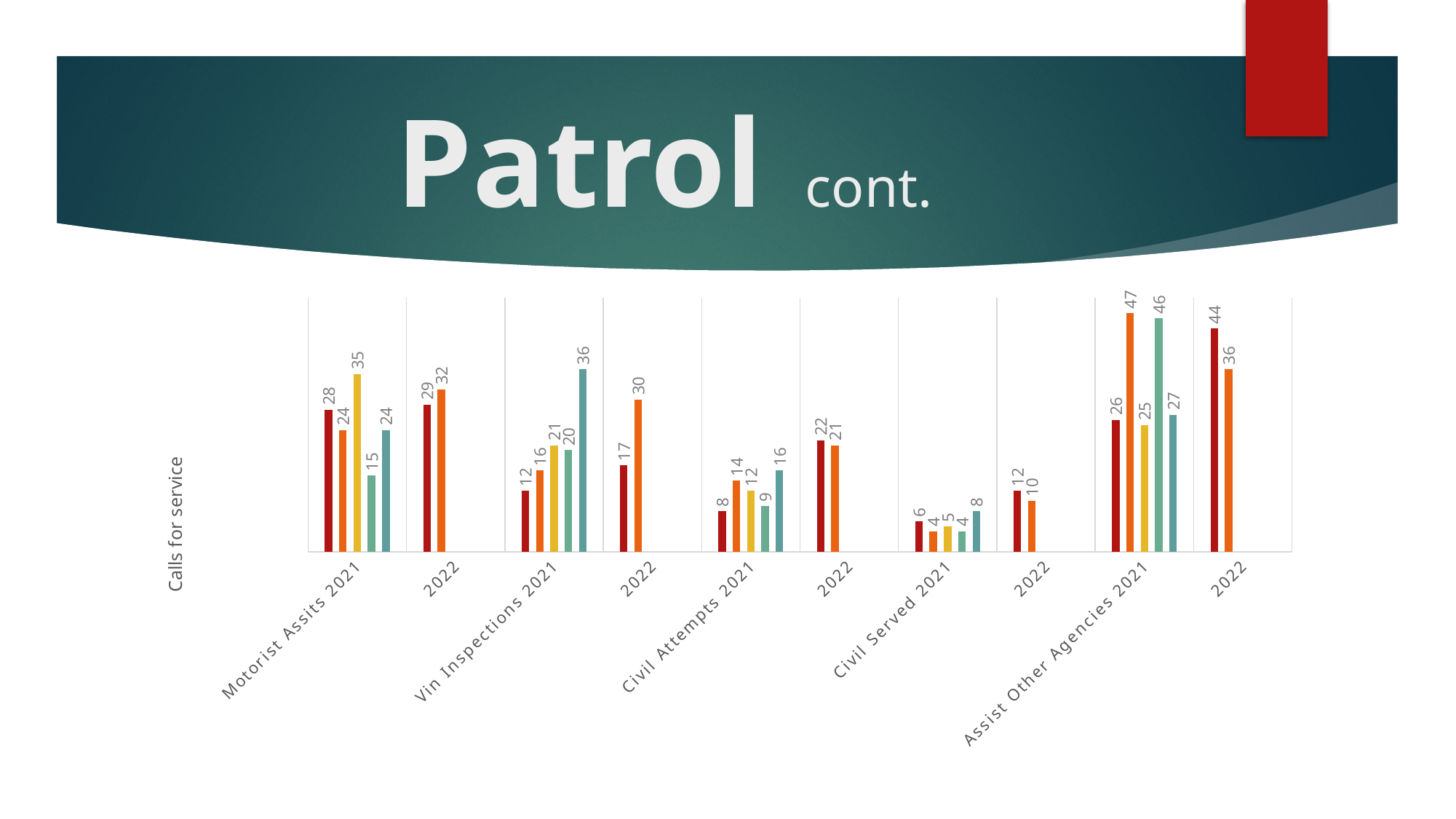
What is the value of the orange (second) bar in the Assist Other Agencies 2021 group? 47 What is the value of the first (dark red) bar in the Civil Served 2022 group? 12 What kind of chart is shown on the slide? bar chart Which bar in the Civil Served 2021 group has the highest value? the teal (last) bar, 8 What is the value of the teal (last) bar in the Vin Inspections 2021 group? 36 Which bar in the Civil Attempts 2021 group has the highest value? the teal (last) bar, 16 Which is larger: the orange bar in Vin Inspections 2022 or the orange bar in Motorist Assists 2022? Motorist Assists 2022 (32) What is the difference between the dark red bar (28) and the green bar (15) in the Motorist Assists 2021 group? 13 How many categories are shown along the x axis of the chart? 10 What is the difference between the two bars in the Assist Other Agencies 2022 group (44 and 36)? 8 What is the value of the tallest (yellow) bar in the Motorist Assists 2021 group? 35 What is the y-axis title of the chart? Calls for service